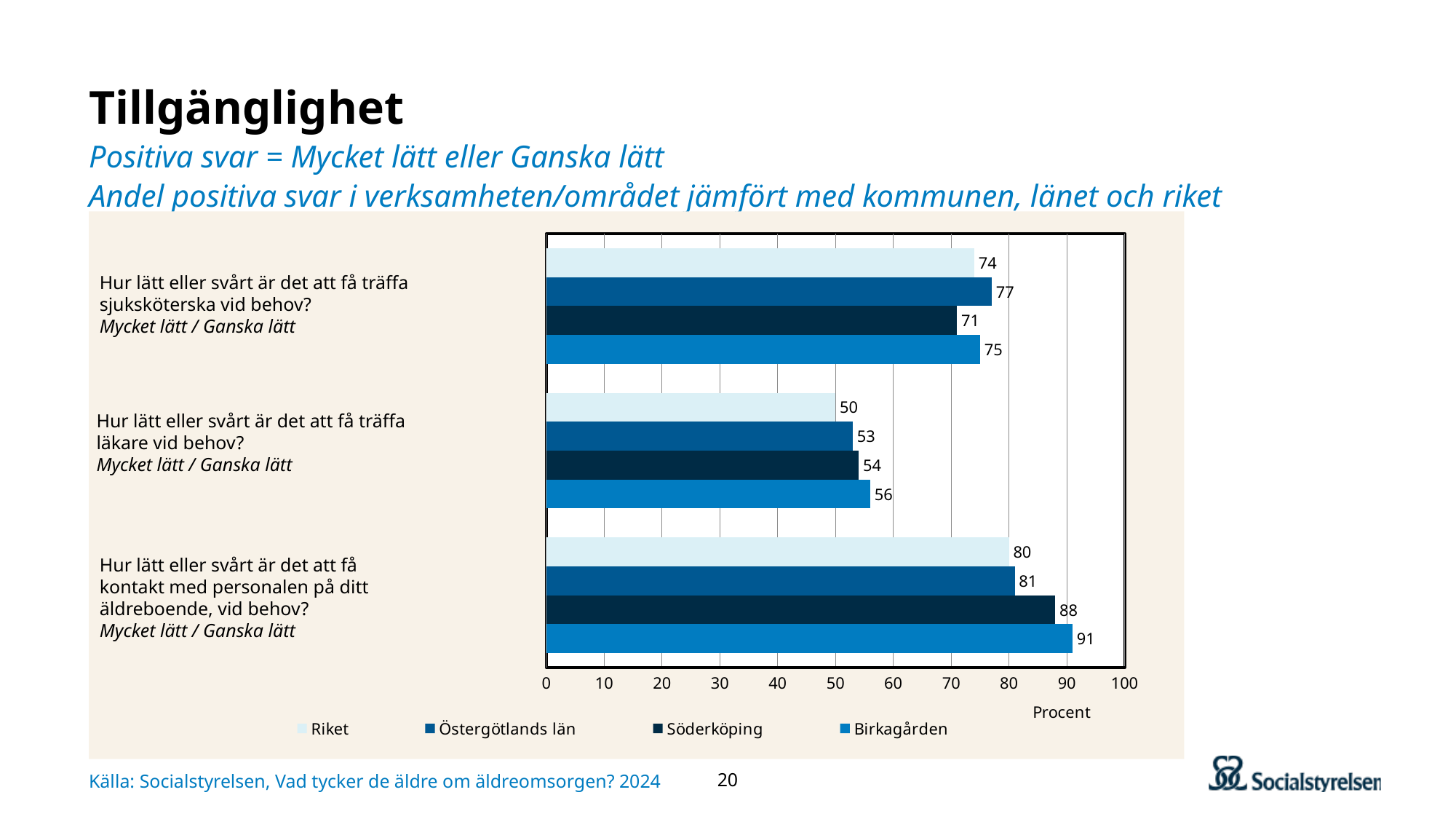
Which is larger on the question about meeting a nurse when needed: the value for Riket or the value for Söderköping? Riket How many question categories are shown on the chart? 3 Which series has the lowest value on the question about meeting a doctor when needed? Riket What is the value for Birkagården on the question about getting in contact with staff at the care home ("Hur lätt eller svårt är det att få kontakt med personalen på ditt äldreboende, vid behov?")? 91 Which series has the highest value on the question about meeting a nurse when needed? Östergötlands län How many series does the legend list? 4 What is the value for Riket on the question about meeting a doctor when needed ("Hur lätt eller svårt är det att få träffa läkare vid behov?")? 50 What is the value for Söderköping on the question about meeting a nurse when needed ("Hur lätt eller svårt är det att få träffa sjuksköterska vid behov?")? 71 What kind of chart is shown on the slide? Bar chart What unit is shown on the horizontal axis of the chart? Procent What is the difference between Birkagården and Östergötlands län on the question about meeting a doctor when needed? 3 What is the difference between Birkagården and Riket on the question about getting in contact with staff at the care home? 11